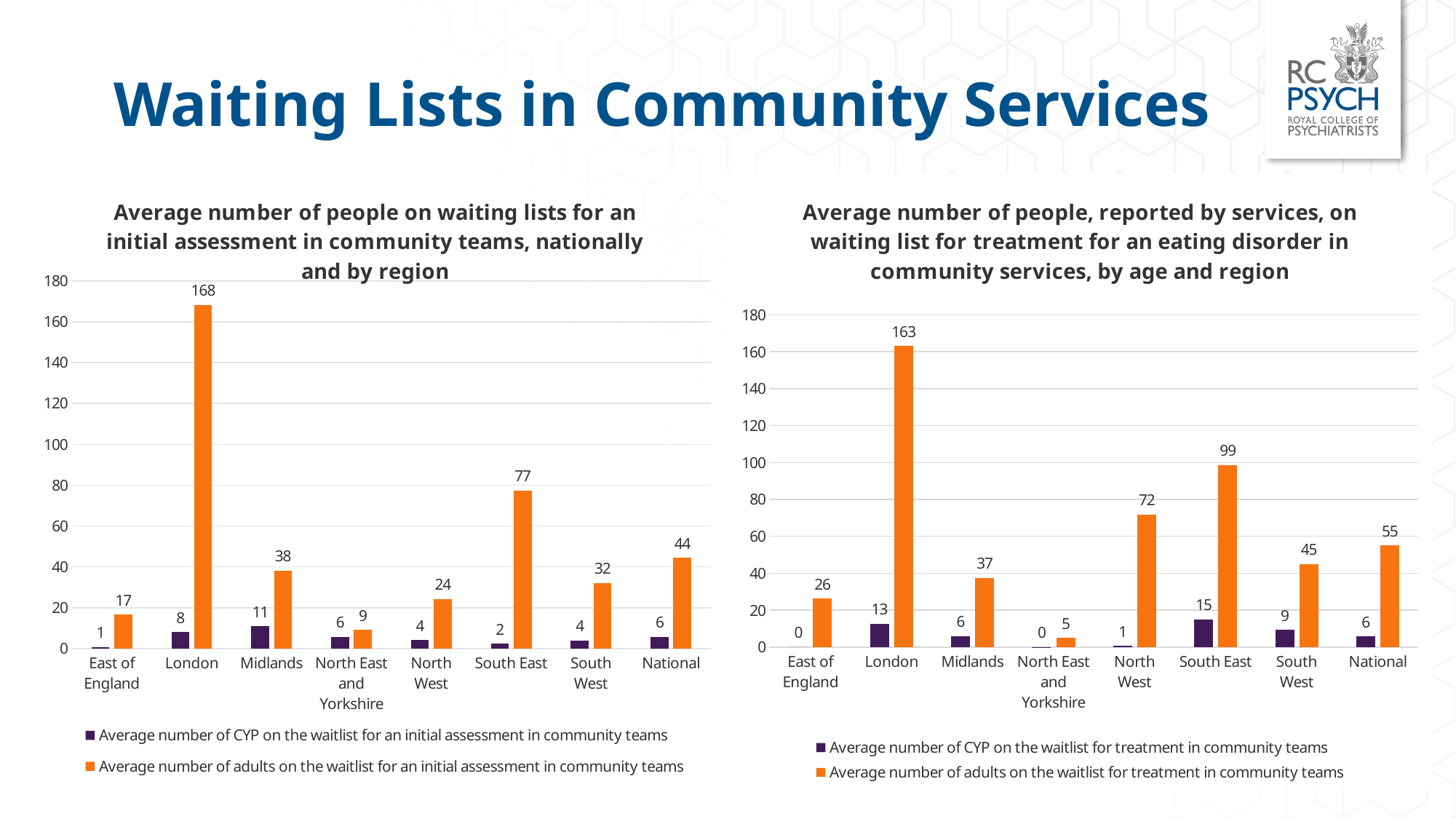
In the left chart (initial assessment), which region has the highest average number of adults on the waitlist? London In the left chart (initial assessment), what is the average number of adults on the waitlist in London? 168 In the right chart (treatment for an eating disorder), what is the average number of adults on the waitlist in the North West? 72 In the right chart (treatment for an eating disorder), which is larger: the adult value for the South West or the adult value for the Midlands? South West In the right chart (treatment for an eating disorder), is the adult value for London greater or less than 140? greater In the left chart (initial assessment), what is the average number of CYP on the waitlist in the Midlands? 11 What kind of chart is the left chart (initial assessment)? Bar chart How many series does the legend of the right chart (treatment for an eating disorder) list? 2 In the right chart (treatment for an eating disorder), what is the average number of CYP on the waitlist in the South East? 15 In the right chart (treatment for an eating disorder), which region has the lowest average number of adults on the waitlist? North East and Yorkshire How many categories are shown on the x axis of the left chart (initial assessment)? 8 In the left chart (initial assessment), what is the difference between the adult and CYP values for the South East? 75